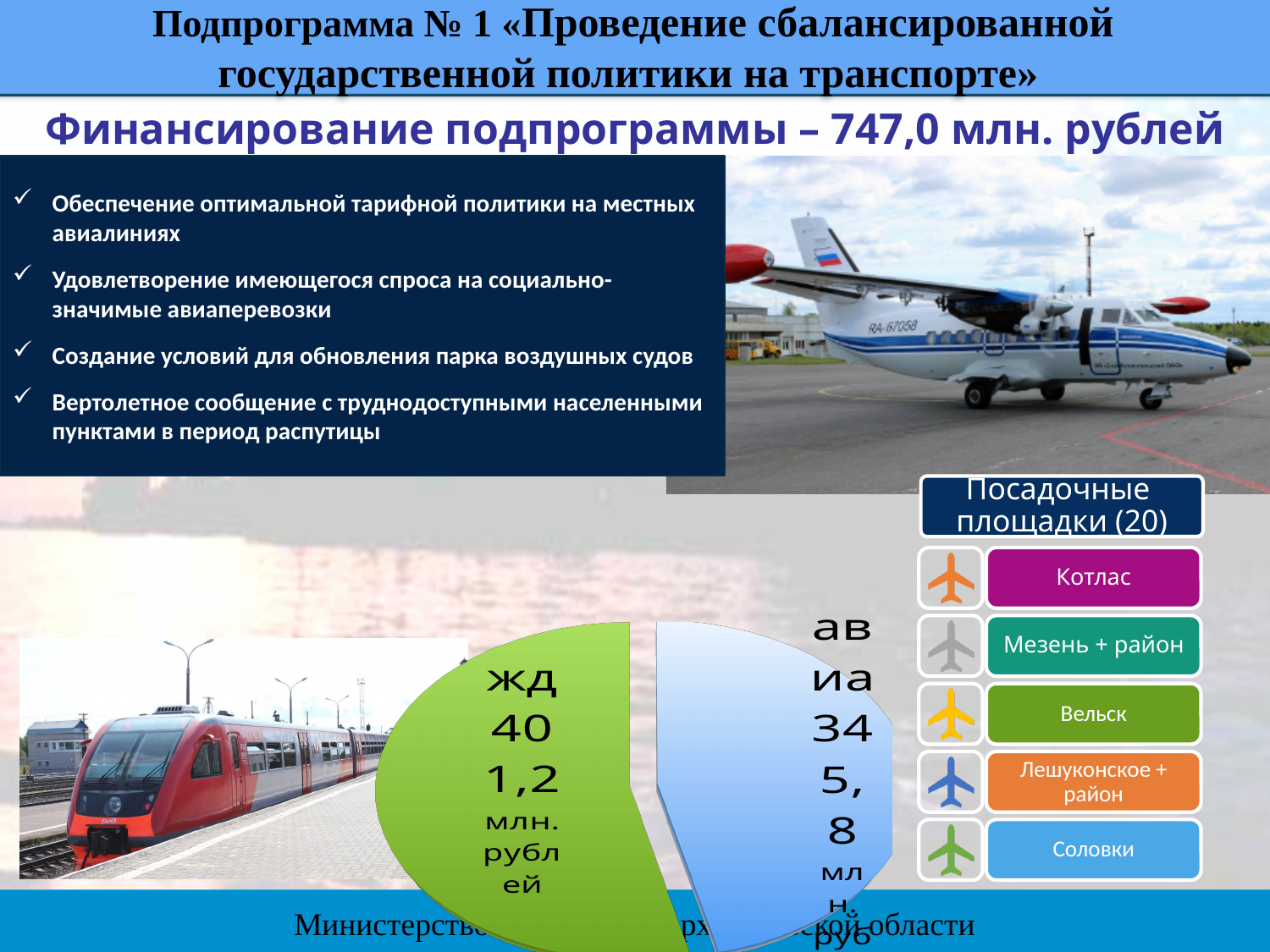
What is the value shown for the авиа slice of the pie chart? 345,8 млн. руб How many slices does the pie chart have? 2 By how much does the жд value exceed the авиа value in the pie chart? 55,4 млн. рублей Which is larger in the pie chart, жд or авиа? жд Which slice of the pie chart is the largest? жд Which slice of the pie chart is the smallest? авиа Is the value for авиа in the pie chart greater or less than 400? less What kind of chart is shown on the slide? pie chart What is the value shown for the жд slice of the pie chart? 401,2 млн. рублей What colour is the авиа slice of the pie chart? blue What is the total of the two slices in the pie chart? 747,0 млн. рублей What colour is the жд slice of the pie chart? green